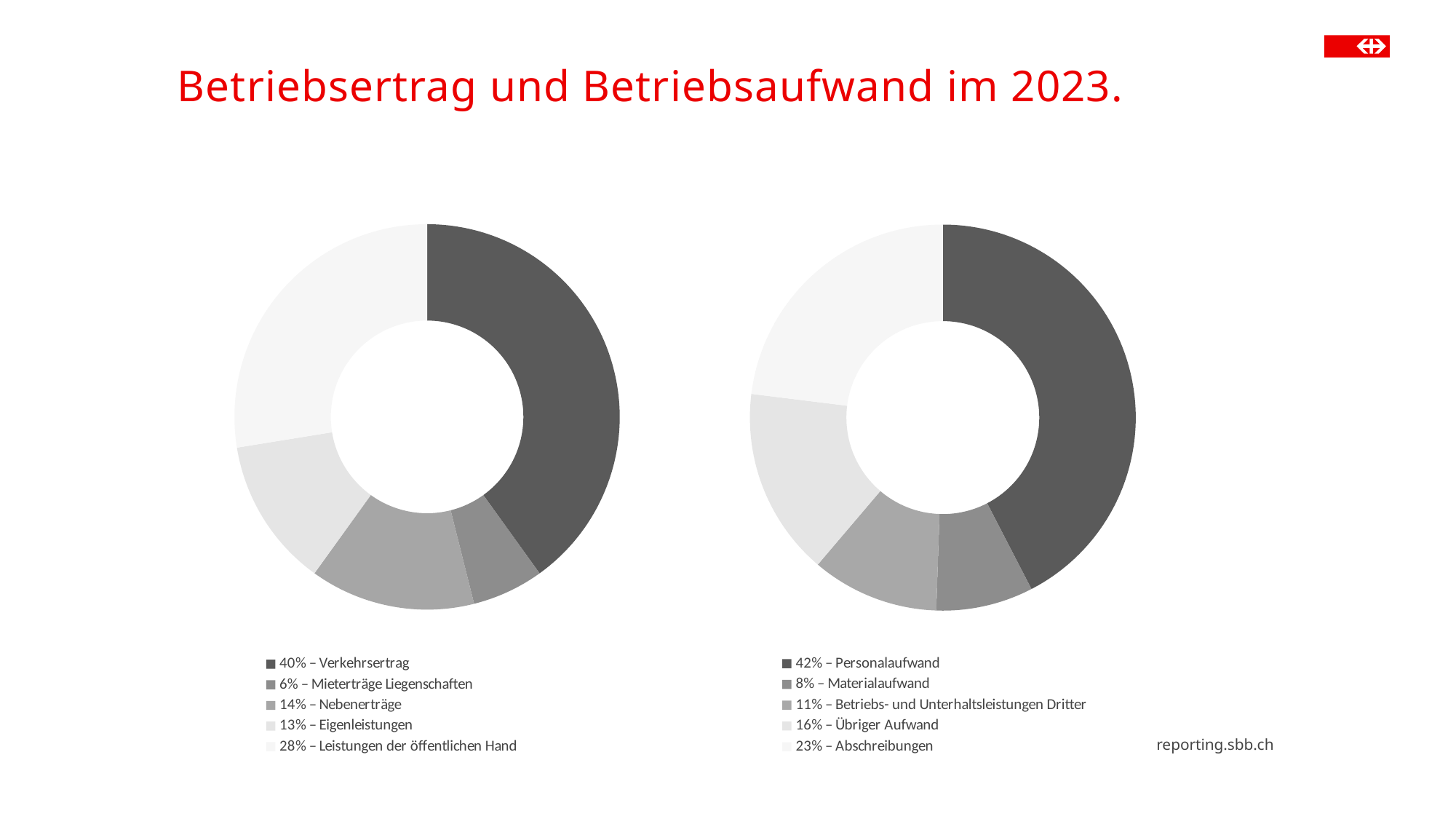
How many categories does the left chart's legend list? 5 In the right chart, which category has the largest share? Personalaufwand In the left chart, which category has the smallest share? Mieterträge Liegenschaften In the left chart, what share does Leistungen der öffentlichen Hand have? 28% In the right chart, what share does Abschreibungen have? 23% In the left chart, what share does Verkehrsertrag have? 40% What is the title of the slide? Betriebsertrag und Betriebsaufwand im 2023. What kind of chart is the right chart? Donut (pie) chart In the left chart, what is the difference in percentage points between Verkehrsertrag and Leistungen der öffentlichen Hand? 12 In the right chart, which category has the smallest share? Materialaufwand In the right chart, which is larger: Übriger Aufwand or Betriebs- und Unterhaltsleistungen Dritter? Übriger Aufwand